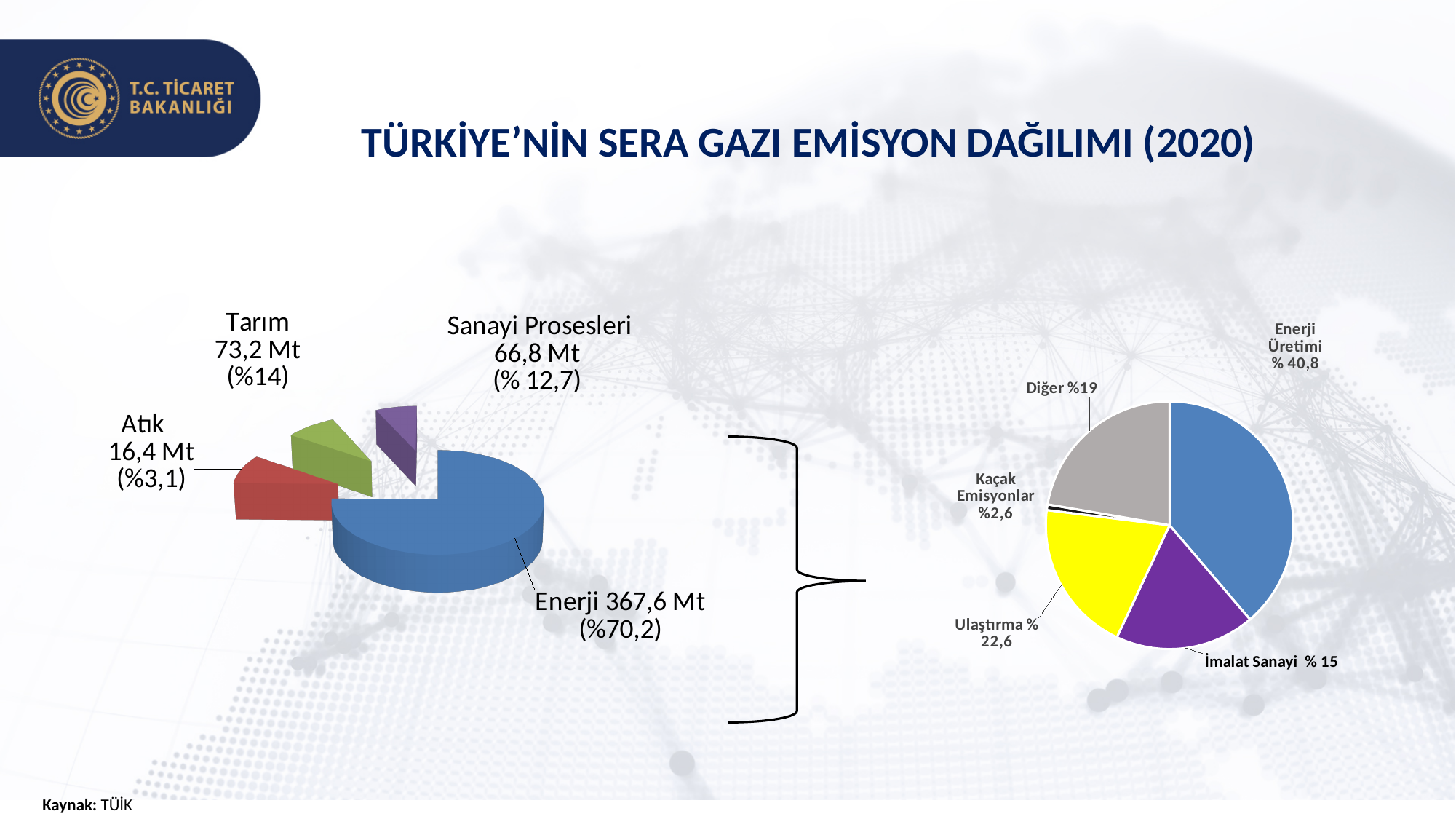
In the left pie chart, what is the value for Enerji? 367,6 Mt In the left pie chart, what is the value for Atık? 16,4 Mt In the left pie chart, what is the difference in Mt between Tarım and Sanayi Prosesleri? 6,4 Mt In the right pie chart, which is larger, Diğer or İmalat Sanayi? Diğer In the right pie chart, what share does Enerji Üretimi have? % 40,8 In the left pie chart, what share does Tarım have? %14 In the left pie chart, how many categories are shown? 4 In the left pie chart, which category has the smallest value? Atık In the right pie chart, what share does Ulaştırma have? % 22,6 What kind of chart is the right chart? Pie chart In the right pie chart, which slice is the smallest? Kaçak Emisyonlar In the left pie chart, which category has the largest value? Enerji